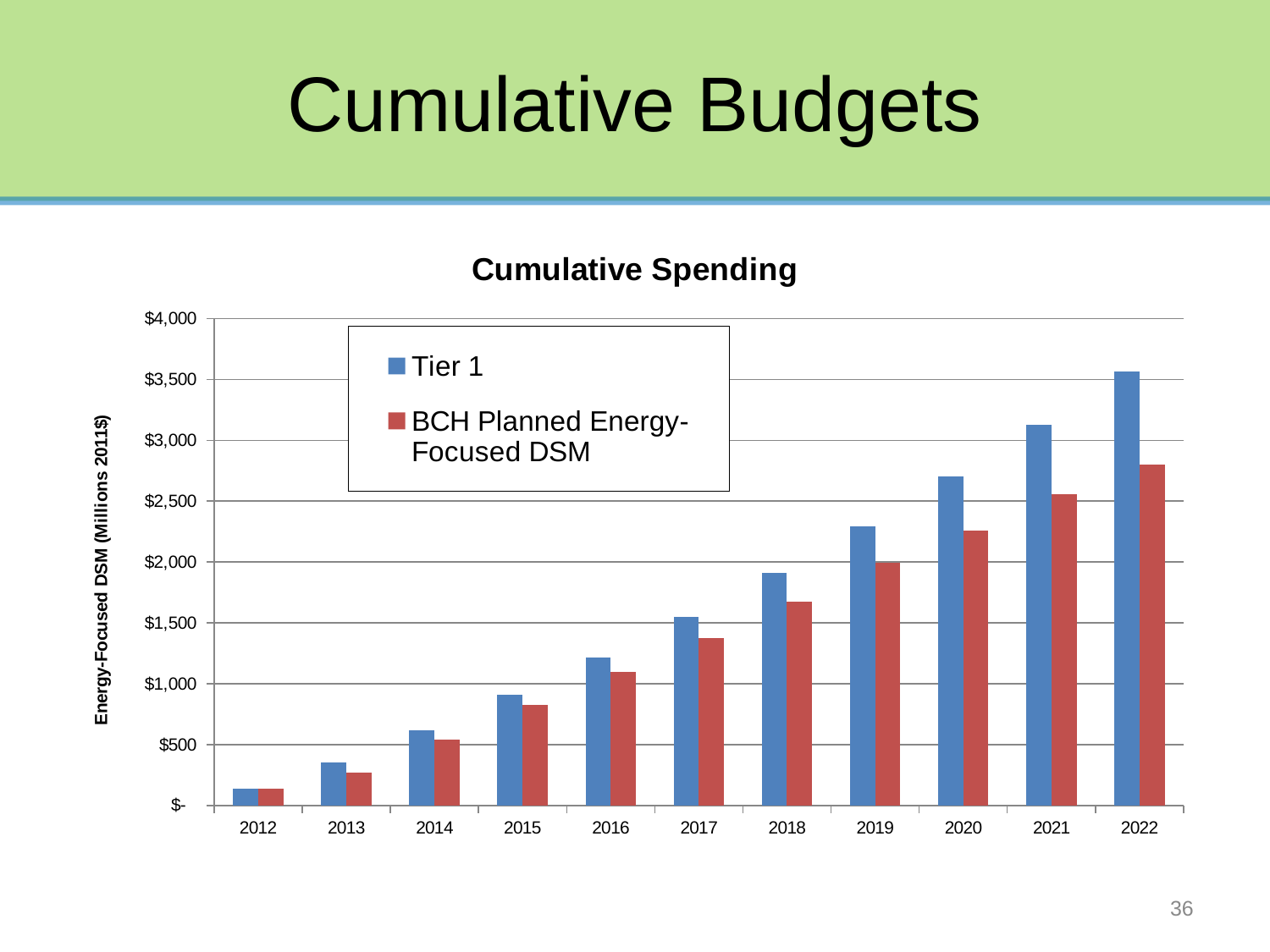
Is the BCH Planned Energy-Focused DSM value for 2013 greater or less than $500? less Is the Tier 1 value for 2022 greater or less than $3,000? greater Do the Tier 1 values rise or fall from 2012 to 2022? Rise How many series does the legend list? 2 What type of chart is shown on the slide? Bar chart Is the BCH Planned Energy-Focused DSM value for 2022 greater or less than $3,000? less What is the title of the chart? Cumulative Spending How many years are shown on the x axis? 11 In which year is the BCH Planned Energy-Focused DSM cumulative spending lowest? 2012 In 2021, which series has the larger value, Tier 1 or BCH Planned Energy-Focused DSM? Tier 1 In which year is the Tier 1 cumulative spending highest? 2022